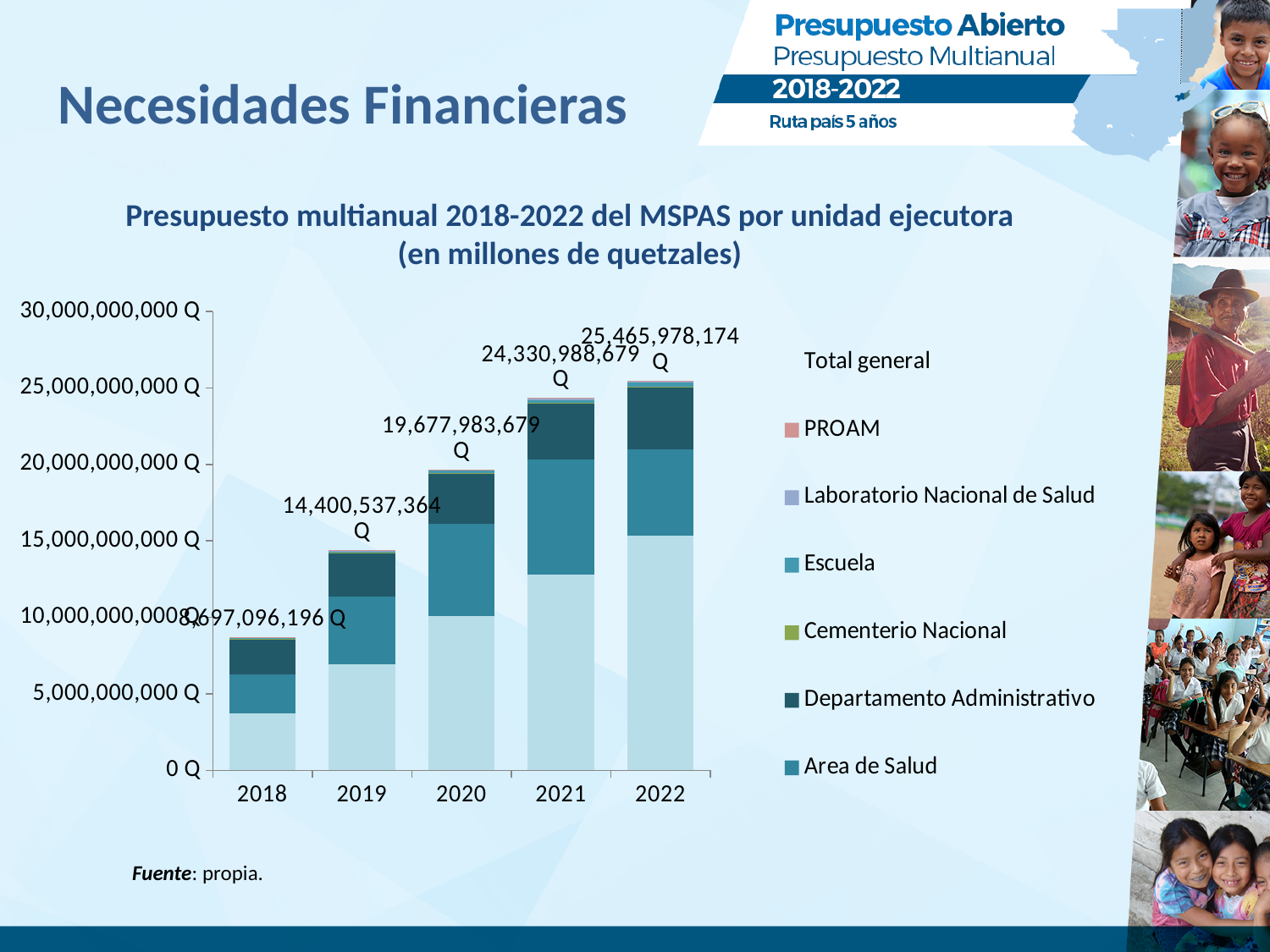
What is the total value labelled for 2019? 14,400,537,364 Q Which year has the larger total, 2021 or 2020? 2021 What is the total value labelled for 2020? 19,677,983,679 Q What is the title of the chart? Presupuesto multianual 2018-2022 del MSPAS por unidad ejecutora (en millones de quetzales) Do the totals rise or fall from 2018 to 2022? rise Which year has the lowest total? 2018 What is the difference between the totals for 2022 and 2021? 1,134,989,495 Q Is the Area de Salud value for 2021 greater or less than 10,000,000,000 Q? less What kind of chart is shown on the slide? stacked bar chart How many years are shown on the x axis of the chart? 5 What is the total value labelled for 2022? 25,465,978,174 Q Which year has the highest total? 2022